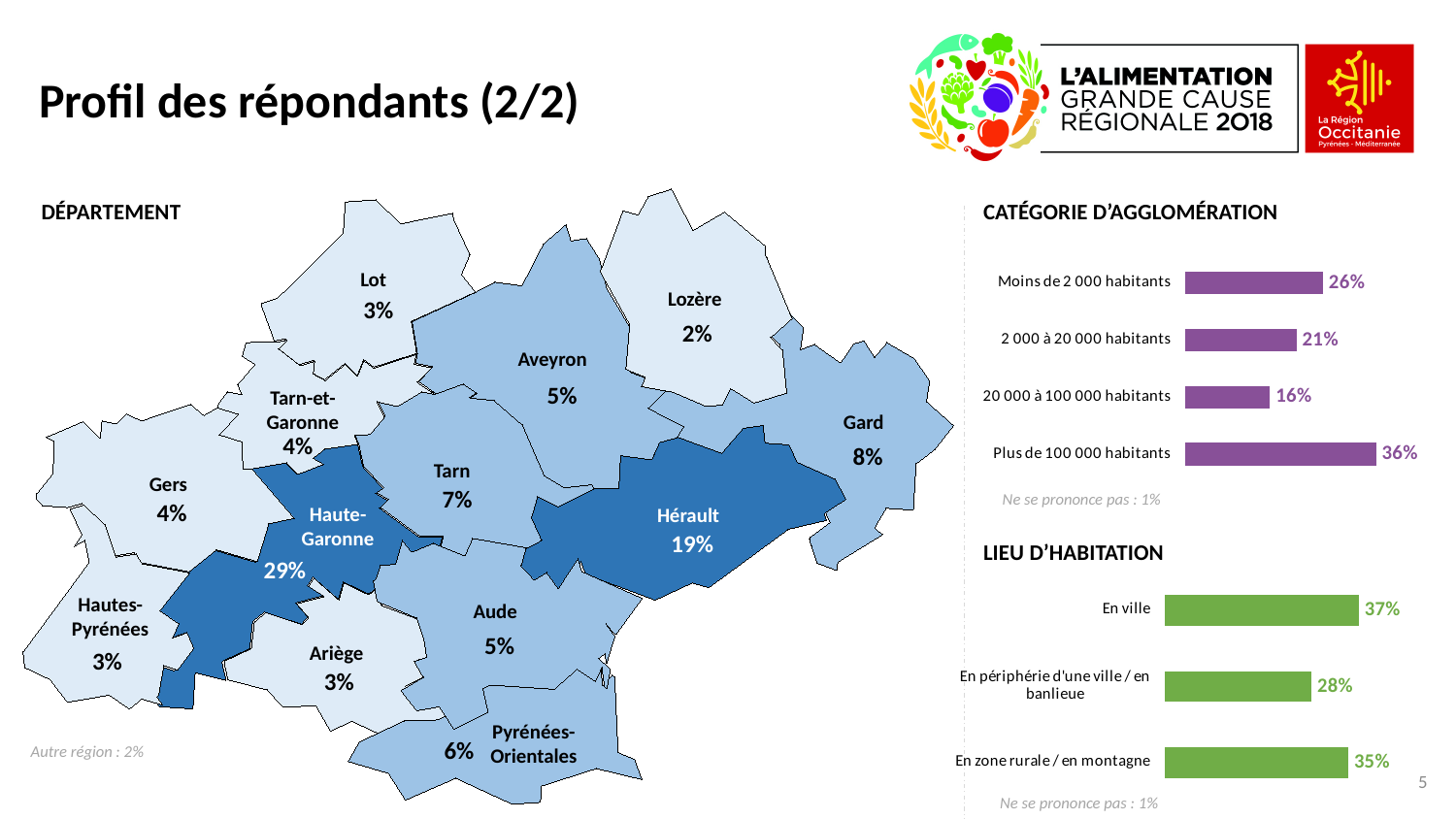
What type of chart is the LIEU D'HABITATION chart? Bar chart In the LIEU D'HABITATION chart, what is the difference between 'En ville' and 'En périphérie d'une ville / en banlieue'? 9% In the CATÉGORIE D'AGGLOMÉRATION chart, what is the value for 'Plus de 100 000 habitants'? 36% In the LIEU D'HABITATION chart, which is larger: 'En ville' or 'En zone rurale / en montagne'? En ville In the CATÉGORIE D'AGGLOMÉRATION chart, which category has the highest value? Plus de 100 000 habitants In the LIEU D'HABITATION chart, what is the value for 'En périphérie d'une ville / en banlieue'? 28% In the CATÉGORIE D'AGGLOMÉRATION chart, what is the value for '2 000 à 20 000 habitants'? 21% What colour are the bars in the CATÉGORIE D'AGGLOMÉRATION chart? Purple In the CATÉGORIE D'AGGLOMÉRATION chart, which category has the lowest value? 20 000 à 100 000 habitants In the LIEU D'HABITATION chart, what is the value for 'En ville'? 37% How many categories are shown in the CATÉGORIE D'AGGLOMÉRATION bar chart? 4 In the CATÉGORIE D'AGGLOMÉRATION chart, what is the difference between 'Plus de 100 000 habitants' and 'Moins de 2 000 habitants'? 10%